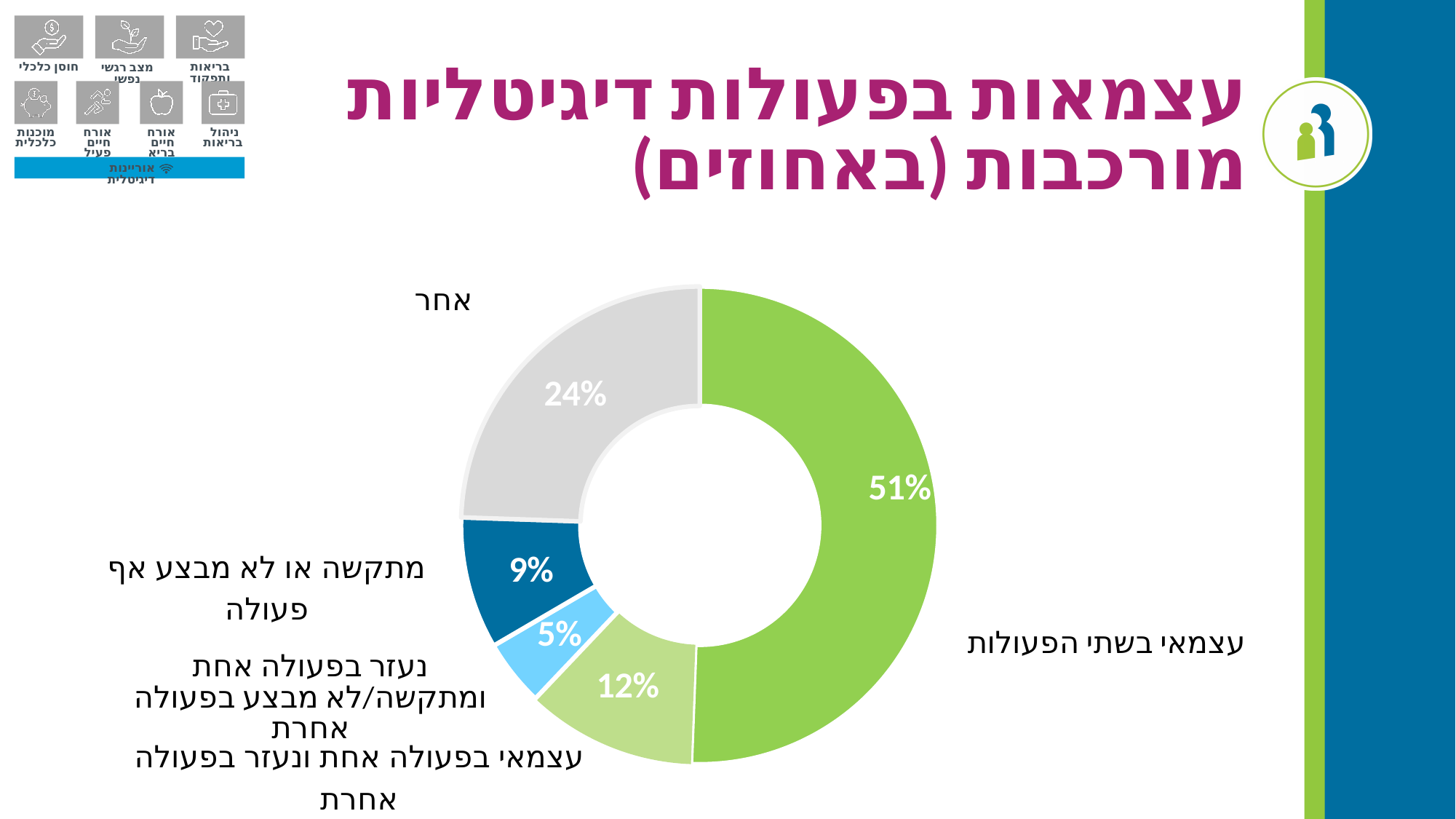
Which slice of the chart is the largest? עצמאי בשתי הפעולות What kind of chart is shown on the slide? Donut (pie) chart Which slice of the chart is the smallest? נעזר בפעולה אחת ומתקשה/לא מבצע בפעולה אחרת What percentage is shown for the slice labelled "אחר"? 24% What is the title of the chart on the slide? עצמאות בפעולות דיגיטליות מורכבות (באחוזים) What percentage is shown for the slice labelled "עצמאי בשתי הפעולות"? 51% What percentage is shown for the slice labelled "עצמאי בפעולה אחת ונעזר בפעולה אחרת"? 12% What percentage is shown for the slice labelled "מתקשה או לא מבצע אף פעולה"? 9% Which is larger: the "מתקשה או לא מבצע אף פעולה" slice or the "עצמאי בפעולה אחת ונעזר בפעולה אחרת" slice? עצמאי בפעולה אחת ונעזר בפעולה אחרת What percentage is shown for the slice labelled "נעזר בפעולה אחת ומתקשה/לא מבצע בפעולה אחרת"? 5% How many slices does the chart have? 5 What is the difference in percentage points between the "עצמאי בשתי הפעולות" slice and the "אחר" slice? 27